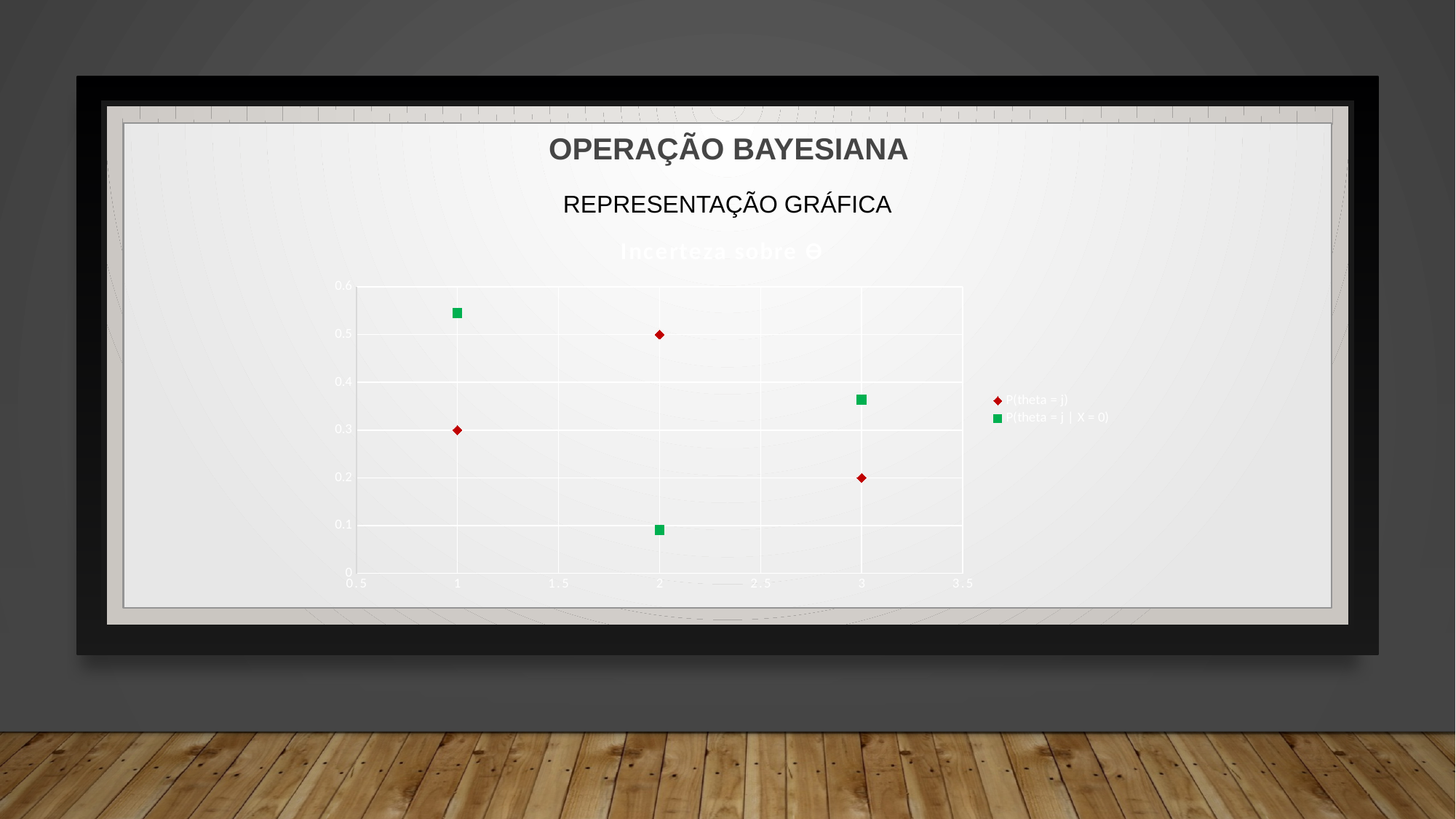
What is the value of P(theta = j) at x = 2? 0.5 What is the title of the chart? Incerteza sobre Θ At which x value is P(theta = j | X = 0) lowest? 2 What is the value of P(theta = j) at x = 3? 0.2 How many series does the legend of the chart list? 2 At x = 3, which series has the larger value, P(theta = j) or P(theta = j | X = 0)? P(theta = j | X = 0) Is the value of P(theta = j | X = 0) at x = 1 greater or less than 0.5? greater What kind of chart is shown on the slide? scatter chart At which x value is P(theta = j) highest? 2 Is the value of P(theta = j | X = 0) at x = 2 greater or less than 0.2? less How many points are plotted for the series P(theta = j)? 3 What is the value of P(theta = j) at x = 1? 0.3